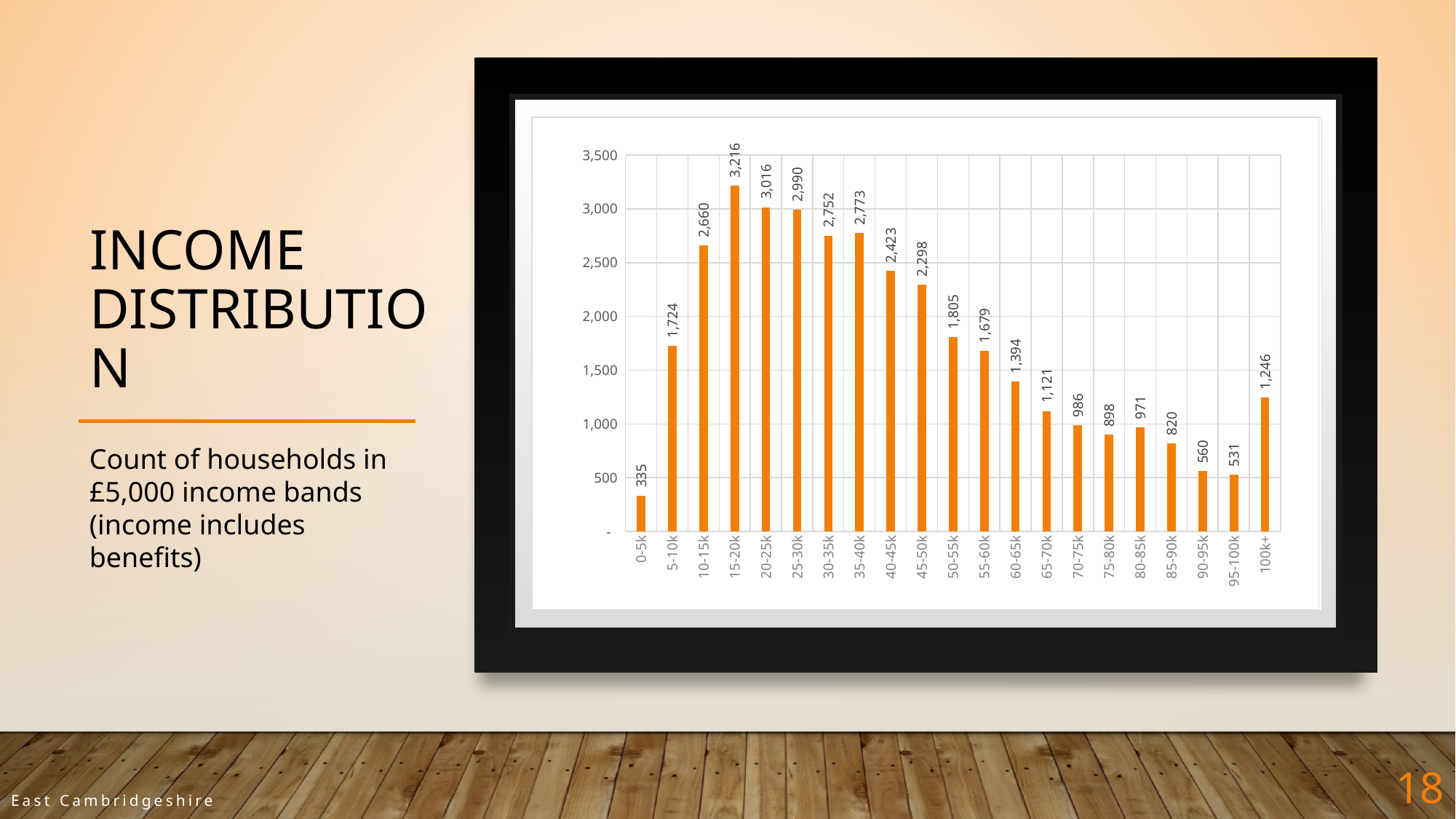
What is the difference between the household counts for the 15-20k and 20-25k bands? 200 What is the difference between the household counts for the 100k+ and 95-100k bands? 715 What is the count of households in the 100k+ income band? 1,246 Which income band has more households, 80-85k or 75-80k? 80-85k Which income band has the highest count of households? 15-20k What kind of chart is shown on the slide? Bar chart Do the household counts rise or fall from the 15-20k band to the 95-100k band? Fall Which income band has the lowest count of households? 0-5k How many income bands are shown on the chart? 21 What is the count of households in the 15-20k income band? 3,216 What is the count of households in the 45-50k income band? 2,298 Is the household count for the 60-65k band greater or less than 1,000? greater